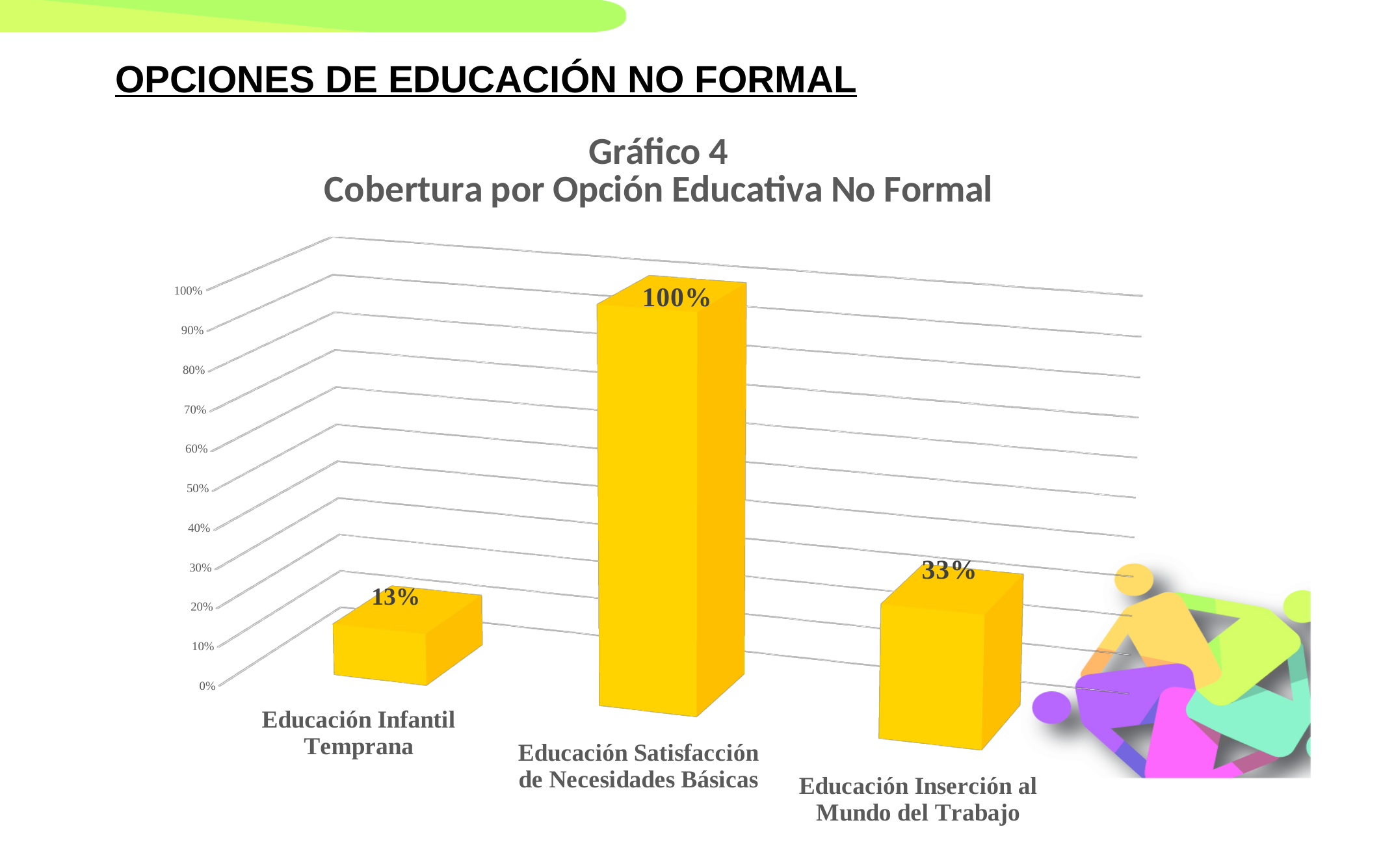
Which is larger, the value for Educación Infantil Temprana or the value for Educación Inserción al Mundo del Trabajo? Educación Inserción al Mundo del Trabajo Which category has the highest value? Educación Satisfacción de Necesidades Básicas What is the title of the chart? Gráfico 4 Cobertura por Opción Educativa No Formal What is the value for Educación Inserción al Mundo del Trabajo? 33% What kind of chart is shown on the slide? bar chart What is the value for Educación Satisfacción de Necesidades Básicas? 100% Which category has the lowest value? Educación Infantil Temprana How many categories are shown in the chart? 3 What is the difference between the values for Educación Inserción al Mundo del Trabajo and Educación Infantil Temprana? 20% What is the value for Educación Infantil Temprana? 13% What is the difference between the values for Educación Satisfacción de Necesidades Básicas and Educación Inserción al Mundo del Trabajo? 67% Is the value for Educación Inserción al Mundo del Trabajo greater or less than 50%? less